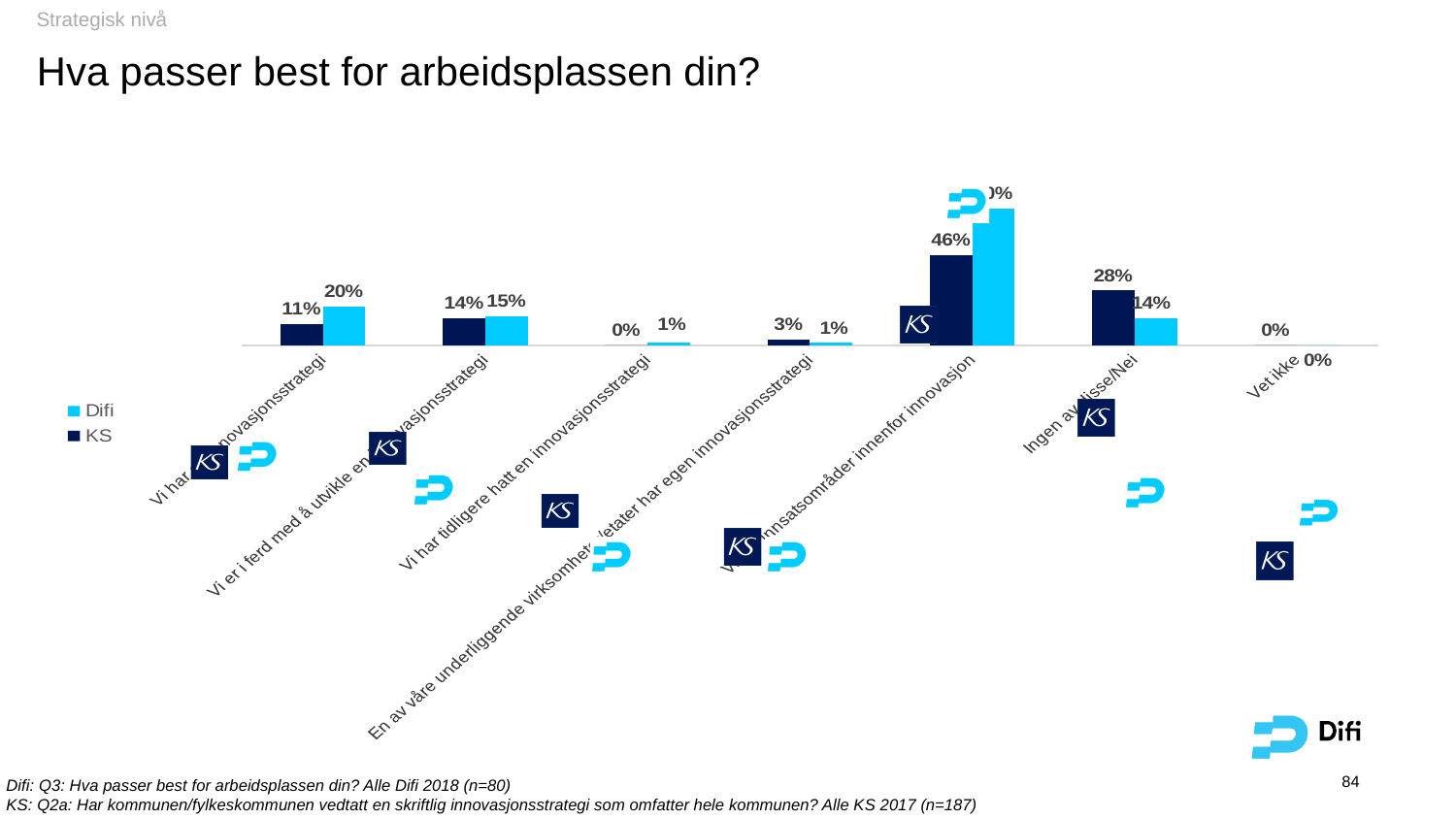
For the second category from the right, is the KS value (28%) or the Difi value (14%) larger? KS Which category has the highest KS value? The fifth category (innsatsområder innenfor innovasjon), 46% Which two series are listed in the legend? Difi and KS What is the Difi value for "Vi er i ferd med å utvikle en innovasjonsstrategi"? 15% What is the KS value for "Vi er i ferd med å utvikle en innovasjonsstrategi"? 14% What is the KS value for the first category on the left? 11% What is the Difi value for "Vet ikke"? 0% What is the Difi value for "Vi har tidligere hatt en innovasjonsstrategi"? 1% How many series does the legend list? 2 What type of chart is shown on the slide? bar chart What is the difference between the Difi value (20%) and the KS value (11%) for the first category on the left? 9% What is the KS value for "Vi har tidligere hatt en innovasjonsstrategi"? 0%